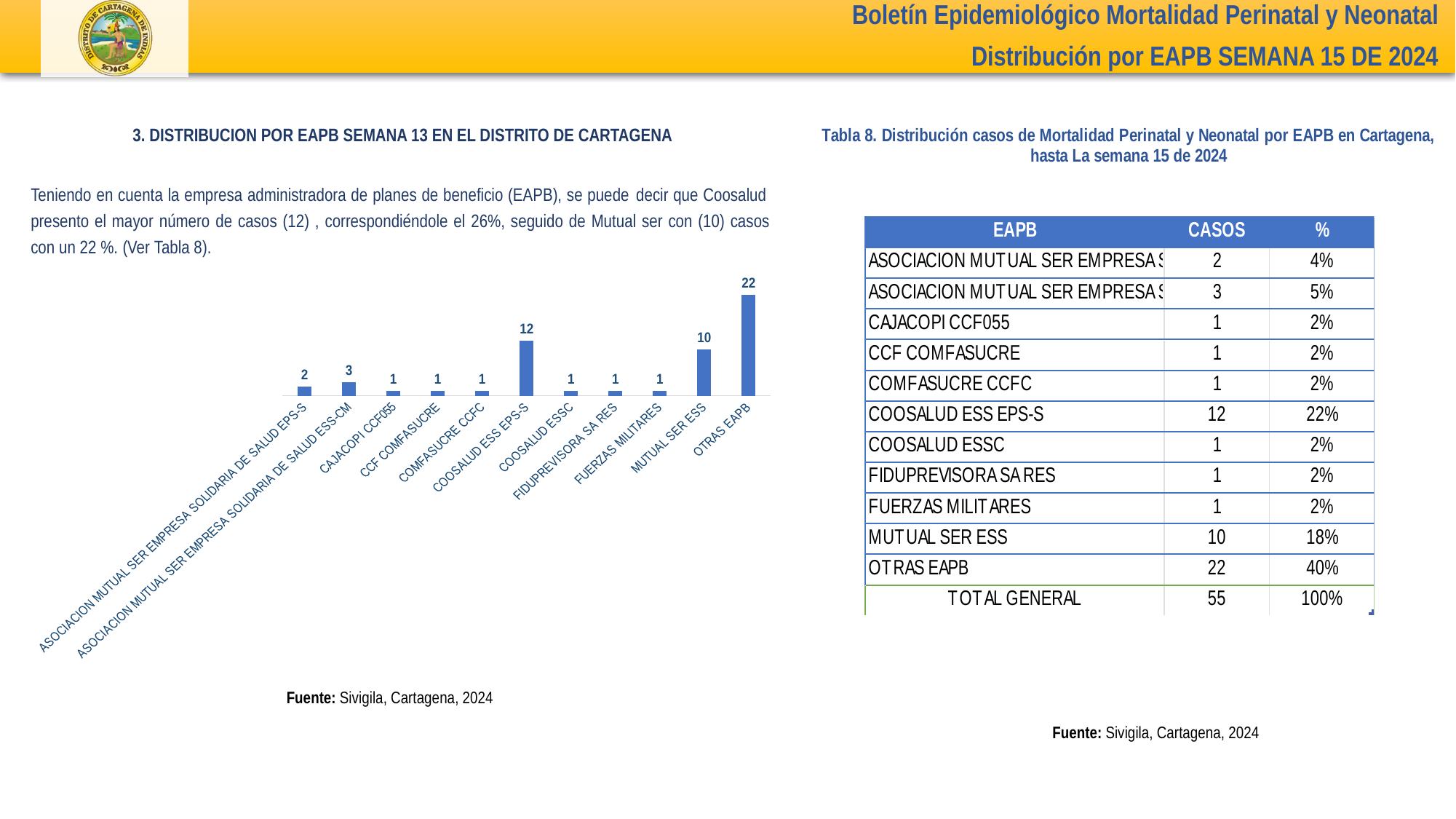
What is the value for ASOCIACION MUTUAL SER EMPRESA SOLIDARIA DE SALUD ESS-CM in the bar chart? 3 What is the value for OTRAS EAPB in the bar chart? 22 Which category has the highest value in the bar chart? OTRAS EAPB Which is larger in the bar chart: the value for MUTUAL SER ESS or the value for ASOCIACION MUTUAL SER EMPRESA SOLIDARIA DE SALUD EPS-S? MUTUAL SER ESS What is the difference between the values for OTRAS EAPB and COOSALUD ESS EPS-S in the bar chart? 10 What is the value for FUERZAS MILITARES in the bar chart? 1 How many categories in the bar chart have a value of 1? 6 What is the difference between the values for COOSALUD ESS EPS-S and MUTUAL SER ESS in the bar chart? 2 What is the value for MUTUAL SER ESS in the bar chart? 10 What is the value for COOSALUD ESS EPS-S in the bar chart? 12 What kind of chart is shown on the slide? Bar chart How many categories are shown in the bar chart? 11